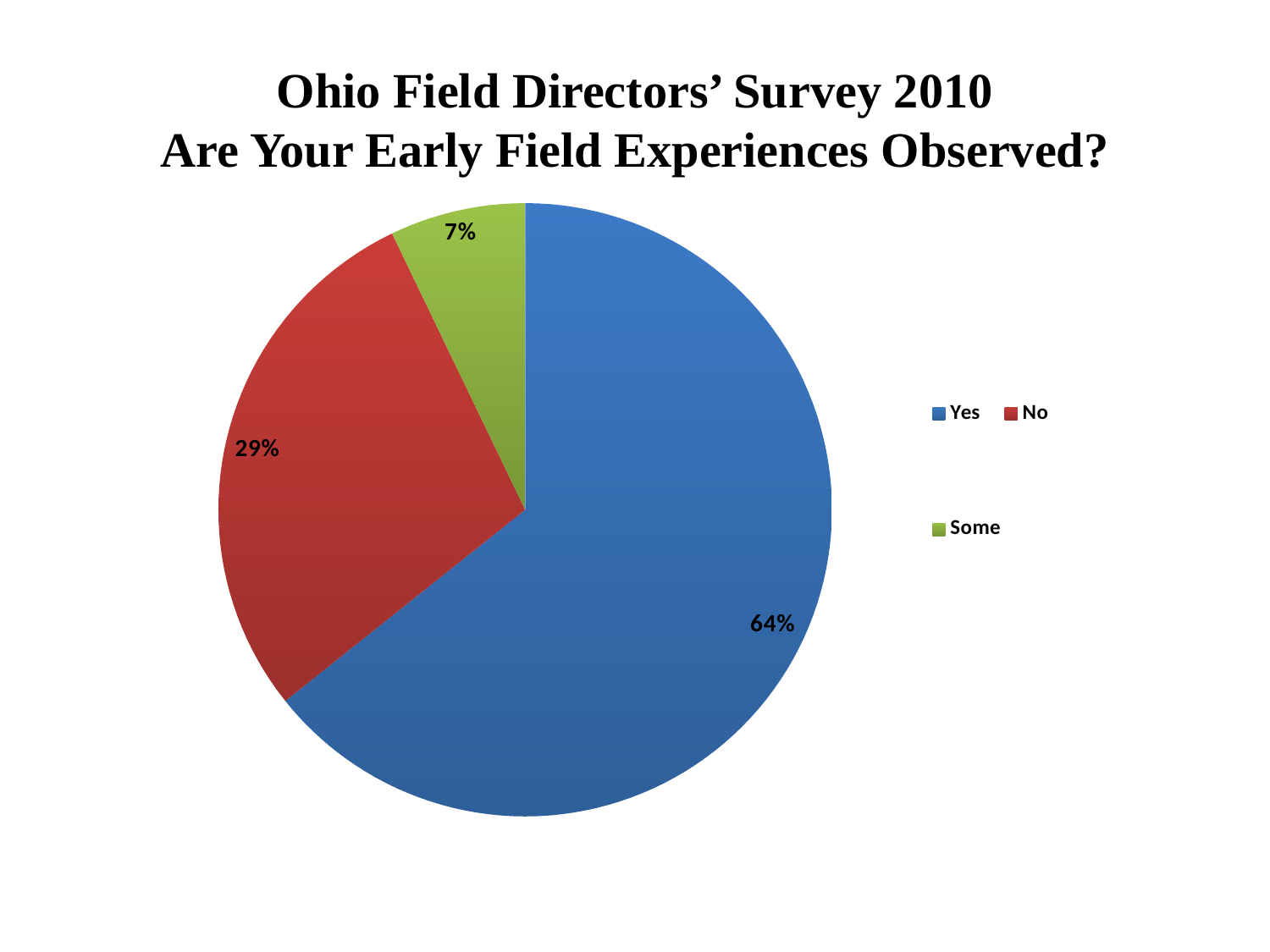
What colour is the "Some" slice? Green What percentage of respondents answered "Yes"? 64% What kind of chart is shown on the slide? Pie chart Which response has the smallest share of the pie? Some Which is larger, the "No" slice or the "Some" slice? No What percentage of respondents answered "No"? 29% How many slices does the pie chart have? 3 How many entries does the legend list? 3 What is the difference in percentage points between the "Yes" and "No" slices? 35 Which response has the largest share of the pie? Yes What percentage of respondents answered "Some"? 7% What is the title of the chart? Ohio Field Directors' Survey 2010 Are Your Early Field Experiences Observed?